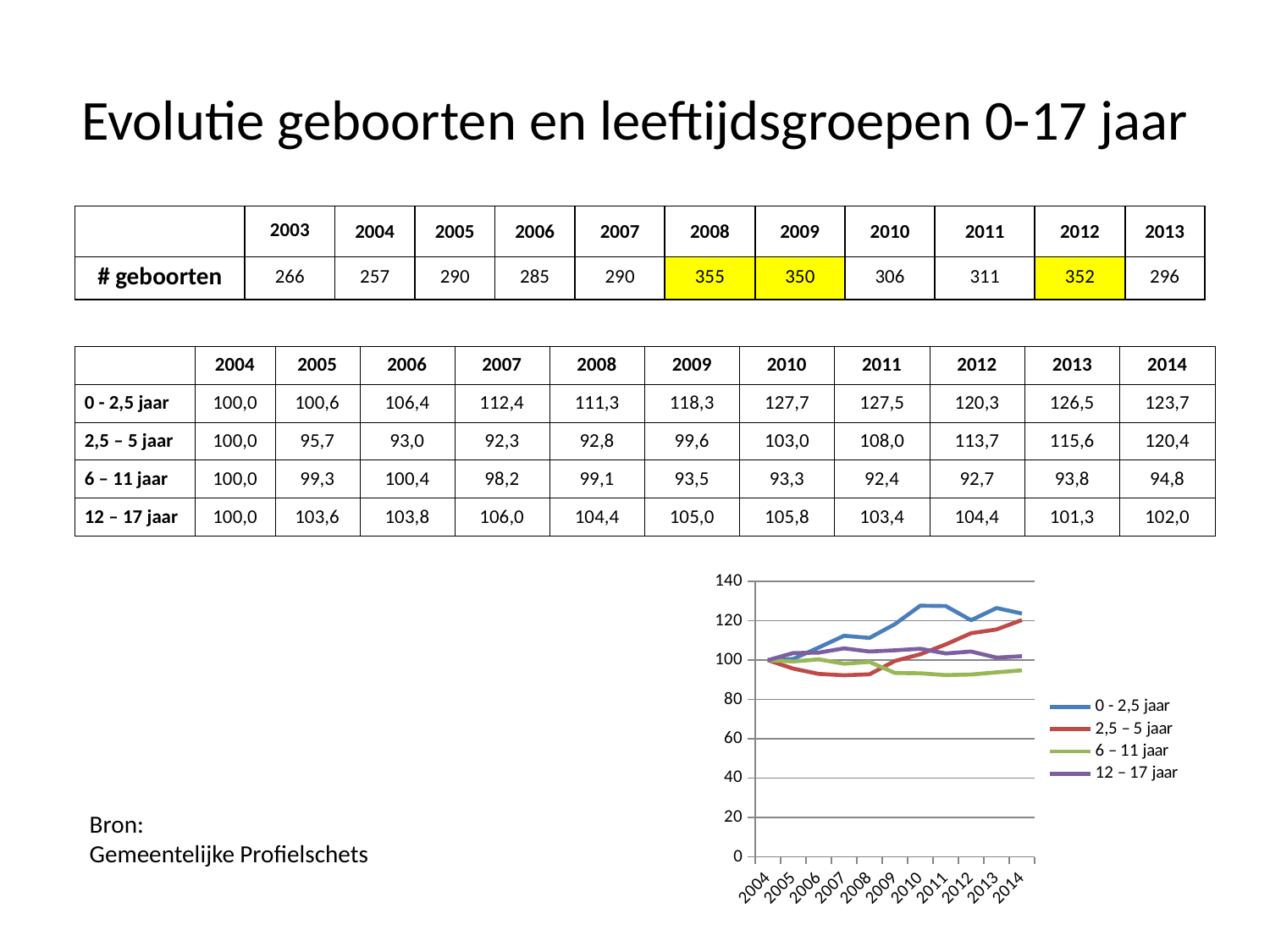
How many series does the chart's legend list? 4 What is the value for 0 - 2,5 jaar in 2010? 127,7 In 2008, which is larger: the value for 0 - 2,5 jaar or for 6 – 11 jaar? 0 - 2,5 jaar What is the difference between the 2,5 – 5 jaar value in 2014 and in 2004? 20,4 How many years are plotted along the x axis of the chart? 11 Is the value for 6 – 11 jaar in 2012 greater or less than 100? less What is the highest value shown on the chart's y axis? 140 What kind of chart is shown on the slide? line chart Does the 6 – 11 jaar series rise or fall overall from 2004 to 2014? fall In which year does the 2,5 – 5 jaar series reach its highest value? 2014 Which series has the lowest value in 2014 on the chart? 6 – 11 jaar Is the value for 0 - 2,5 jaar in 2010 greater or less than 120? greater